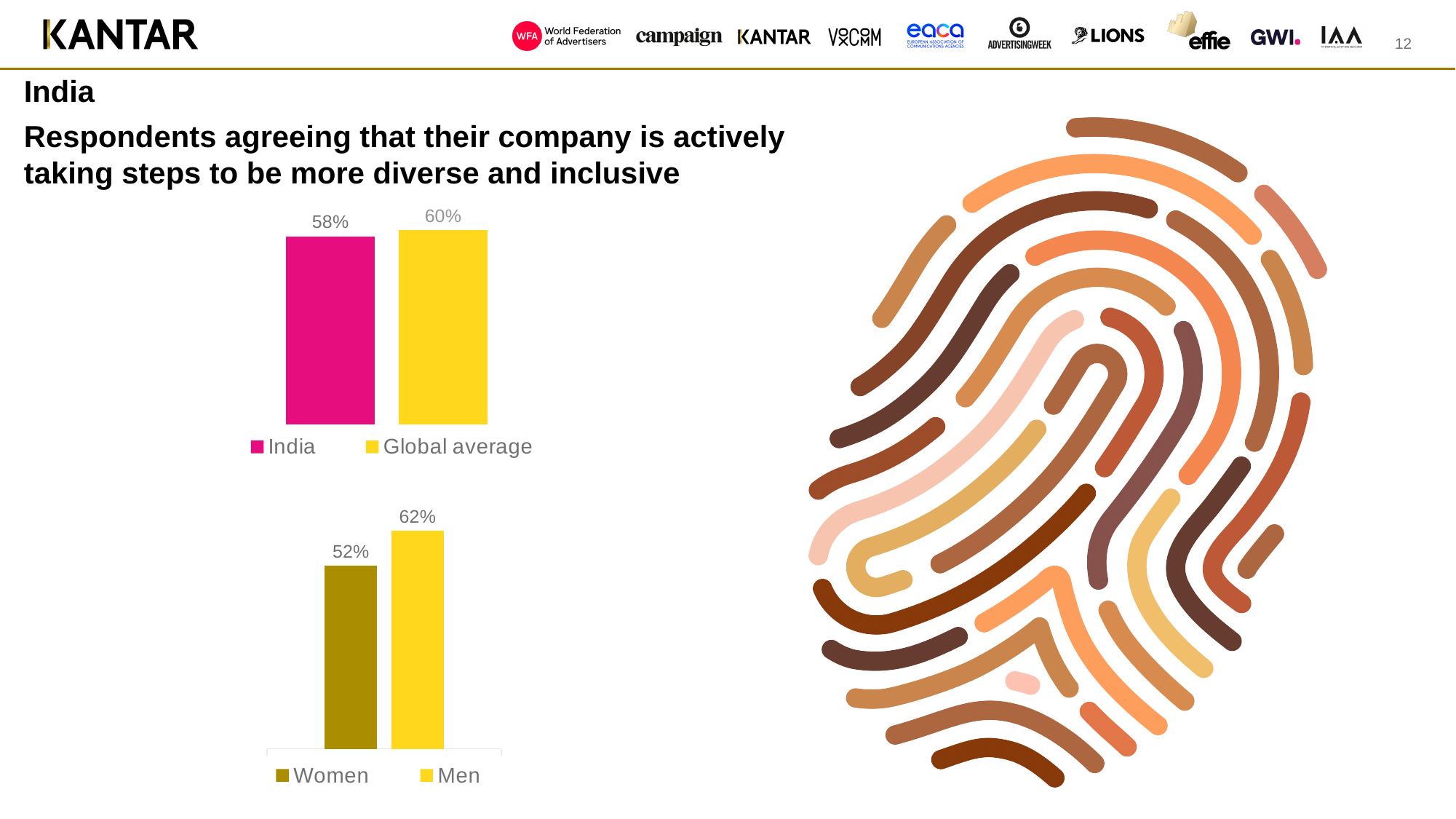
In the bottom chart (Women vs Men), what is the difference between the Men and Women values? 10% In the bottom chart (Women vs Men), what is the value for Women? 52% In the bottom chart (Women vs Men), which is higher, Women or Men? Men In the top chart (India vs Global average), what is the value for India? 58% In the top chart (India vs Global average), what is the value for Global average? 60% How many series does the legend of the bottom chart (Women vs Men) list? 2 In the top chart (India vs Global average), what is the difference between the Global average and India values? 2% In the bottom chart (Women vs Men), what is the value for Men? 62% In the top chart (India vs Global average), which is larger, India or Global average? Global average What kind of chart is the top chart (India vs Global average)? Bar chart In the top chart (India vs Global average), what colour is the India bar? Pink How many bars are shown in the top chart (India vs Global average)? 2